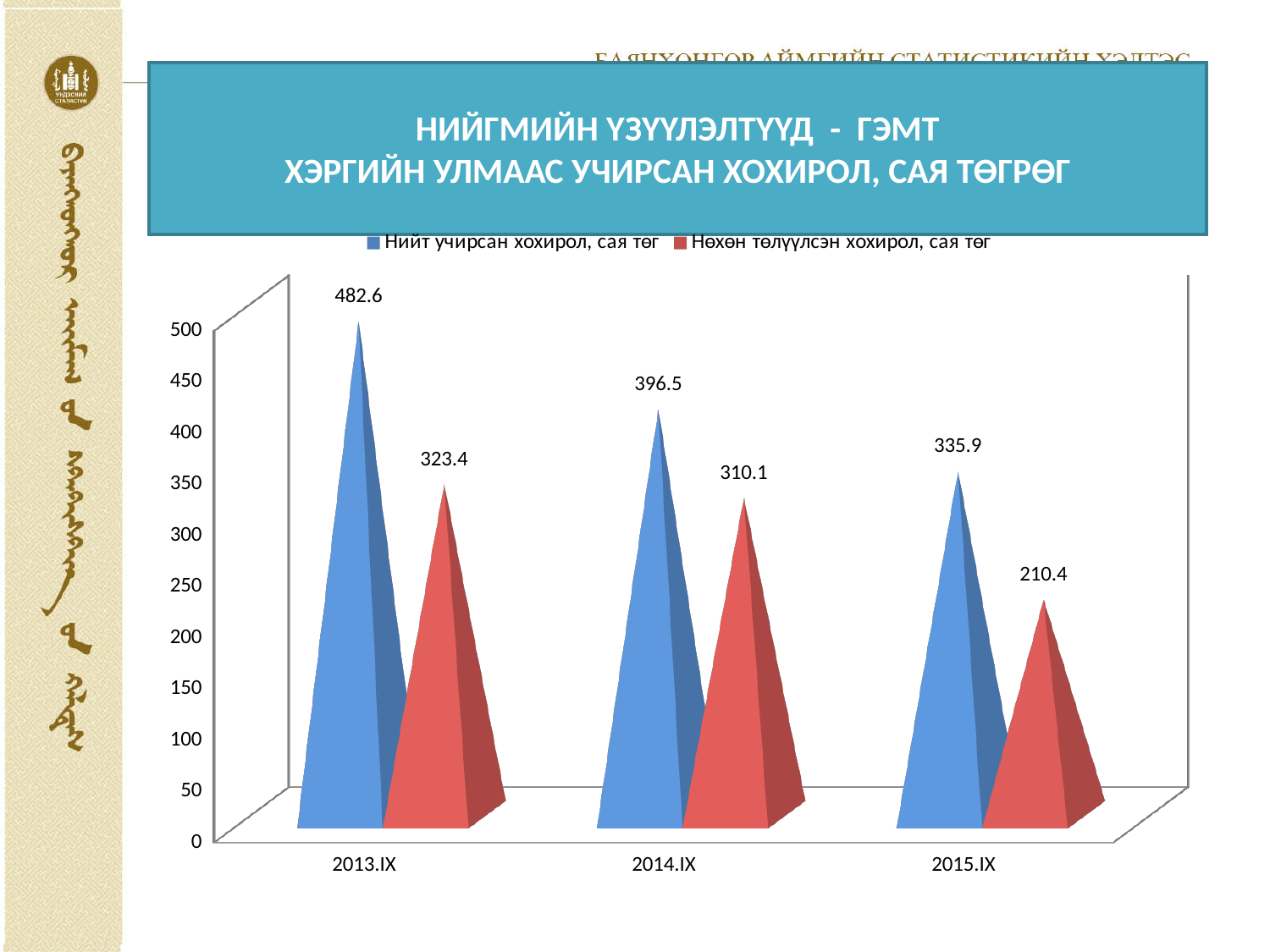
By how much did Нийт учирсан хохирол, сая төг fall from 2013.IX to 2015.IX? 146.7 Does Нийт учирсан хохирол, сая төг rise or fall from 2013.IX to 2015.IX? Fall What is the difference between Нийт учирсан хохирол and Нөхөн төлүүлсэн хохирол in 2013.IX? 159.2 In which period is Нийт учирсан хохирол, сая төг the highest? 2013.IX In which period is Нөхөн төлүүлсэн хохирол, сая төг the lowest? 2015.IX What is the value of Нөхөн төлүүлсэн хохирол, сая төг for 2015.IX? 210.4 What is the value of Нийт учирсан хохирол, сая төг for 2013.IX? 482.6 What is the value of Нөхөн төлүүлсэн хохирол, сая төг for 2014.IX? 310.1 What kind of chart is shown on the slide? Bar chart How many series does the legend list? 2 Which is larger: Нийт учирсан хохирол in 2014.IX or Нөхөн төлүүлсэн хохирол in 2013.IX? Нийт учирсан хохирол in 2014.IX How many periods are shown on the x axis? 3